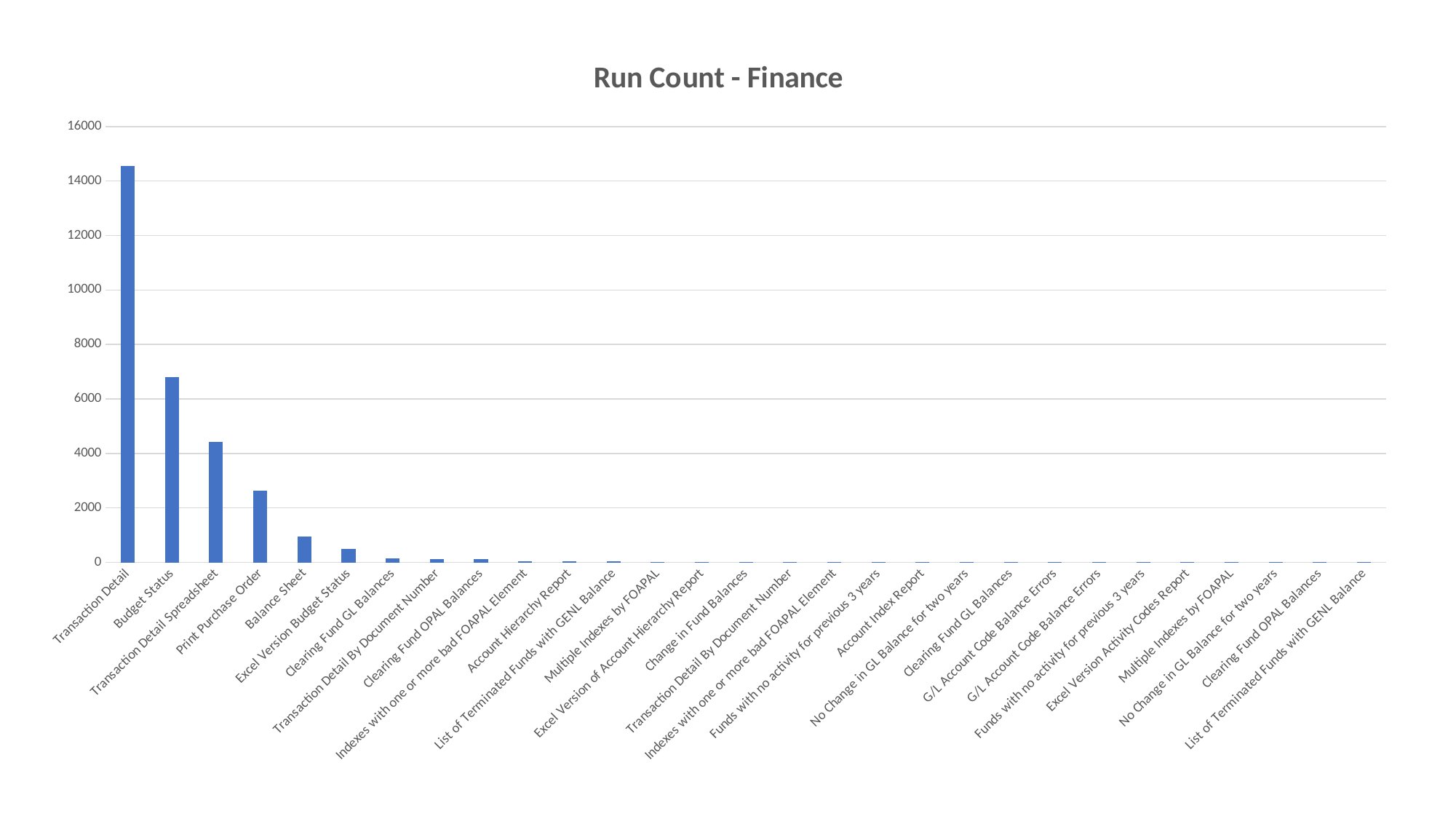
Do the values generally rise or fall moving from left to right along the x axis? fall Is the value for Transaction Detail Spreadsheet greater or less than 4000? greater What kind of chart is shown on the slide? bar chart Is the value for Transaction Detail greater or less than 14000? greater Is the value for Balance Sheet greater or less than 2000? less Which is larger, the value for Budget Status or the value for Transaction Detail Spreadsheet? Budget Status What is the title of the chart? Run Count - Finance Which category has the highest run count? Transaction Detail Which is larger, the value for Print Purchase Order or the value for Balance Sheet? Print Purchase Order